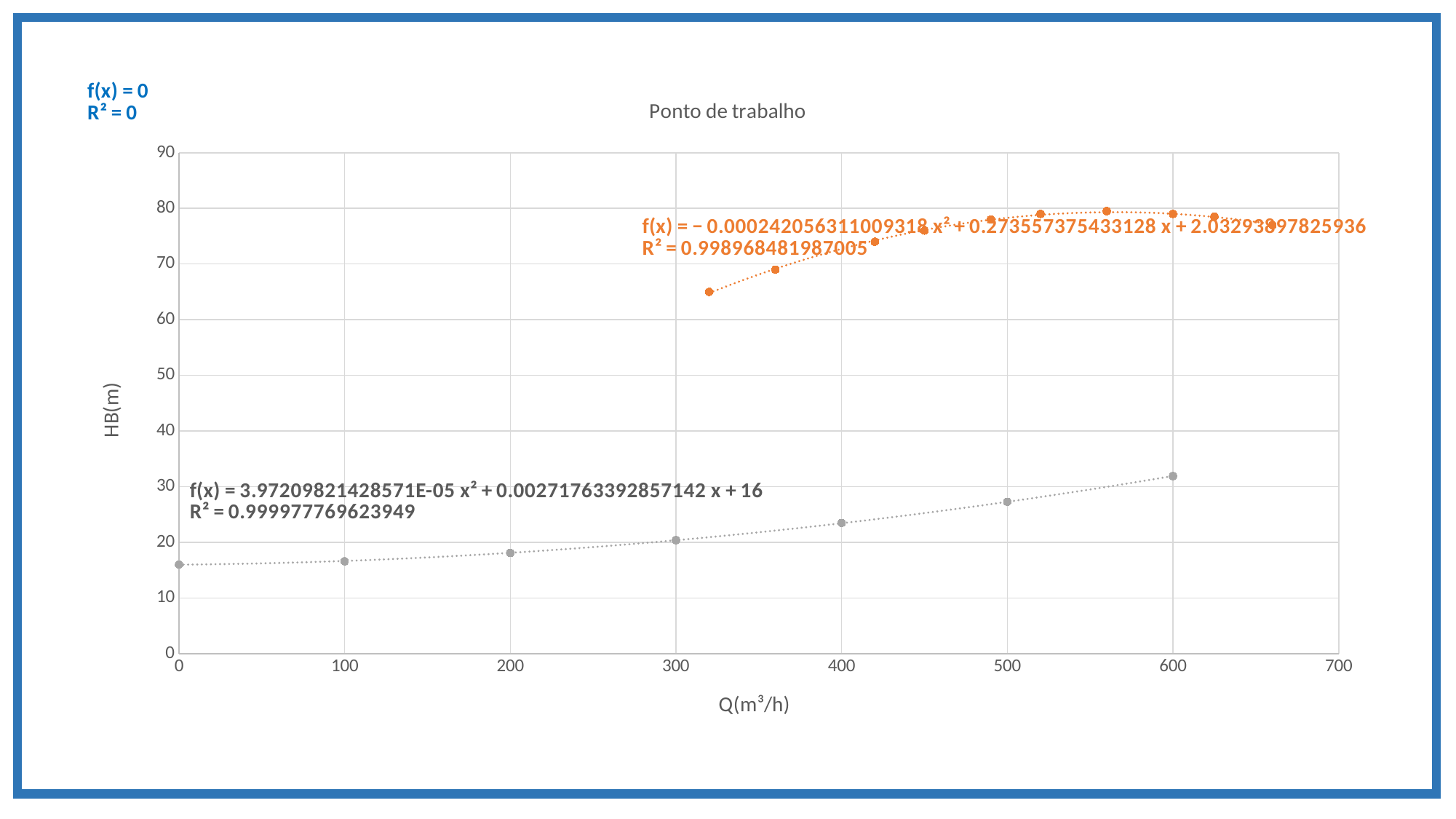
At which Q value does the gray series reach its highest HB value? 600 Is the HB value of the orange series at Q = 560 greater or less than 70? greater What is the title of the chart? Ponto de trabalho Is the HB value of the orange series at Q = 320 greater or less than 60? greater At which Q value does the gray series have its lowest HB value? 0 How many data points does the gray series have? 7 What is the R² value printed for the gray series trendline? 0.999977769623949 Do the values of the gray series rise or fall as Q increases along the x axis? rise Is the HB value of the gray series at Q = 600 greater or less than 20? greater What kind of chart is shown on the slide? scatter chart At Q = 600, which series has the higher HB value, the orange series or the gray series? orange series